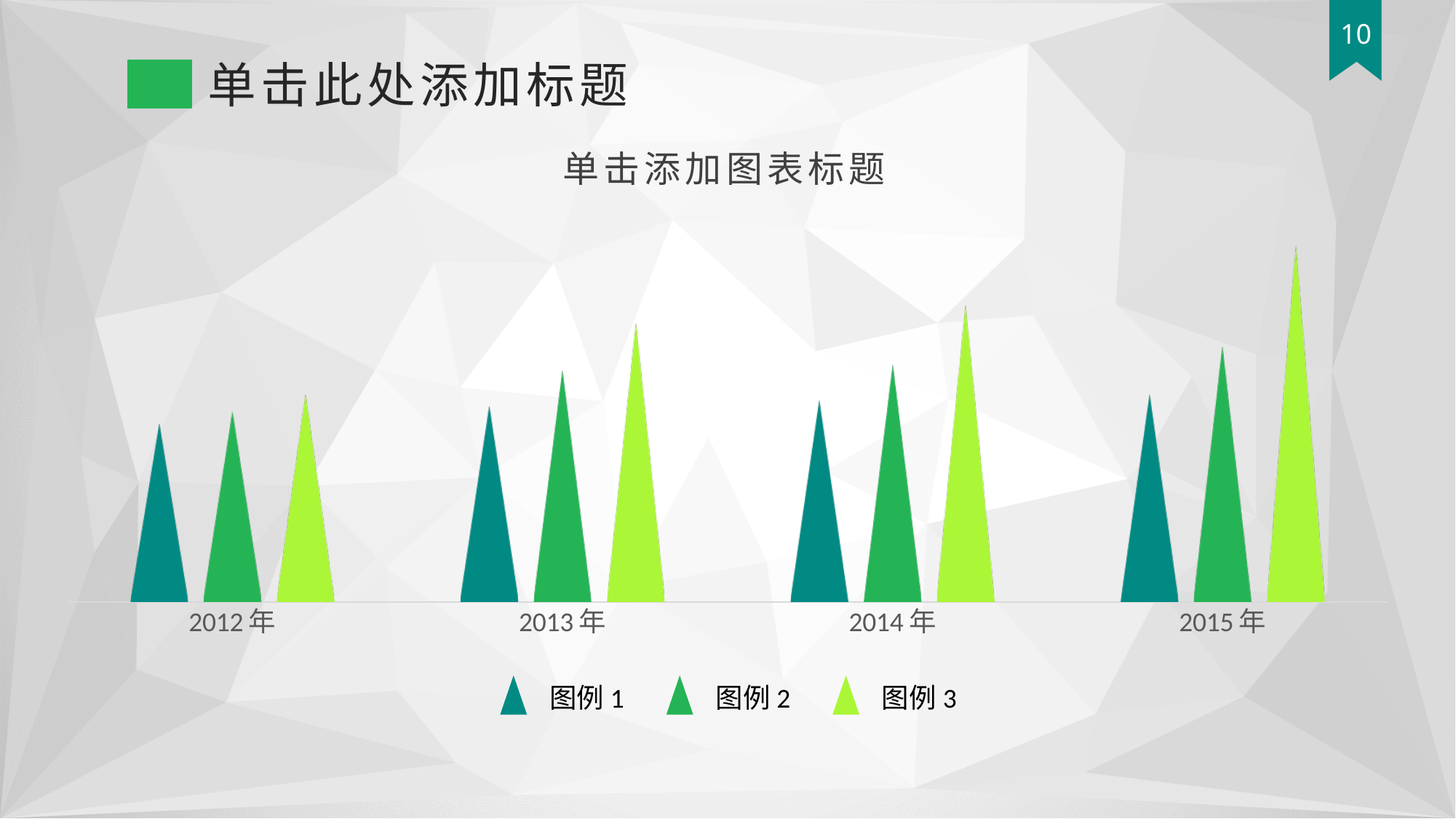
In which year is the value for 图例 3 highest? 2015 年 How many categories (years) are shown on the x axis of the chart? 4 In 2012 年, which series has the larger value, 图例 1 or 图例 3? 图例 3 What kind of chart is shown on the slide? bar chart How many series does the chart's legend list? 3 In 2015 年, which series has the larger value, 图例 1 or 图例 3? 图例 3 What is the title of the chart? 单击添加图表标题 Do the values for 图例 3 rise or fall from 2012 年 to 2015 年? rise In which year is the value for 图例 3 lowest? 2012 年 In which year is the value for 图例 2 lowest? 2012 年 What are the legend entries of the chart? 图例 1, 图例 2, 图例 3 Do the values for 图例 2 rise or fall from 2012 年 to 2015 年? rise